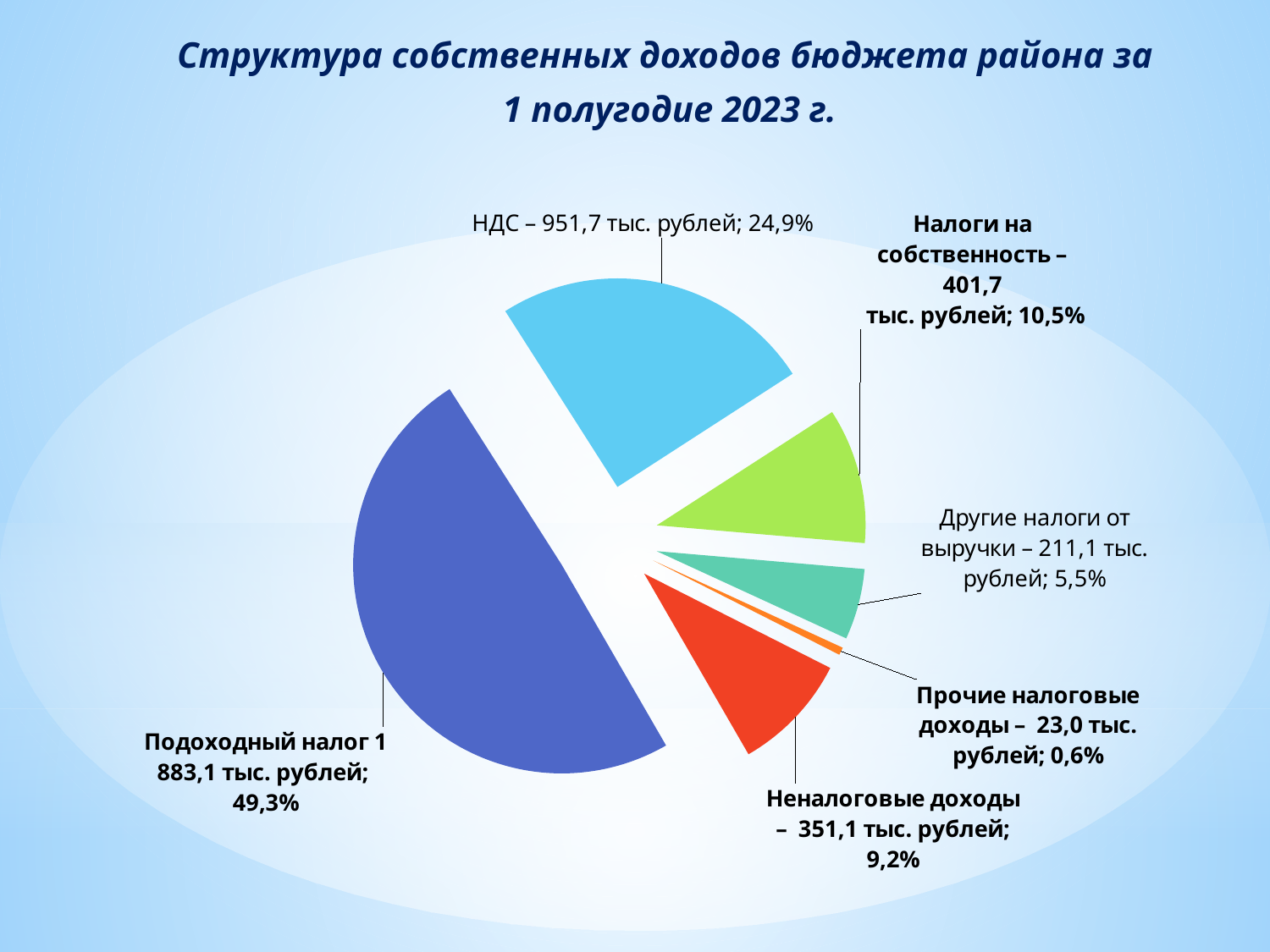
Which category has the largest share of the pie? Подоходный налог What share of the pie does Неналоговые доходы account for? 9,2% What kind of chart is shown on the slide? Pie chart Which is larger, the value for Неналоговые доходы or the value for Другие налоги от выручки? Неналоговые доходы What is the difference in percentage points between the share of НДС and the share of Налоги на собственность? 14,4 What is the value for Прочие налоговые доходы? 23,0 тыс. рублей Which category has the smallest share of the pie? Прочие налоговые доходы What is the value for Другие налоги от выручки? 211,1 тыс. рублей How many slices does the pie chart have? 6 What is the value for Налоги на собственность? 401,7 тыс. рублей What share of the pie does НДС account for? 24,9% What colour is the slice for Подоходный налог? Dark blue